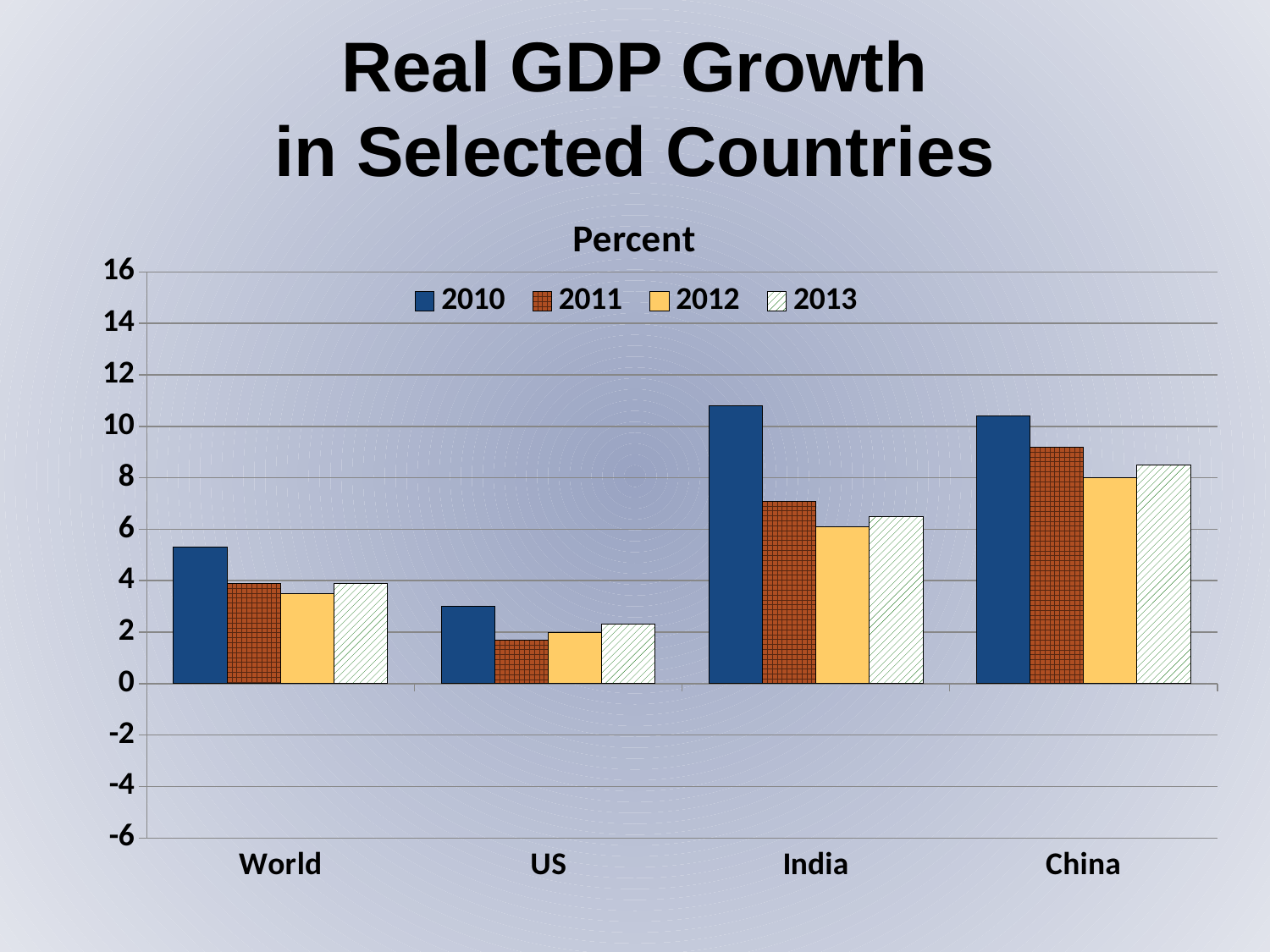
Is the value for India in 2010 greater or less than 10? greater What is the title of the chart? Percent What kind of chart is shown on the slide? bar chart How many countries/regions are shown on the x axis? 4 Is the value for China in 2011 greater or less than 8? greater Which years are listed in the legend? 2010, 2011, 2012, 2013 Do the values for India rise or fall from 2010 to 2012? fall How many series does the legend list? 4 Which category has the highest value for 2010? India Which is larger, the 2010 value for World or the 2010 value for US? World Which category has the lowest value for 2010? US Is the value for US in 2011 greater or less than 2? less